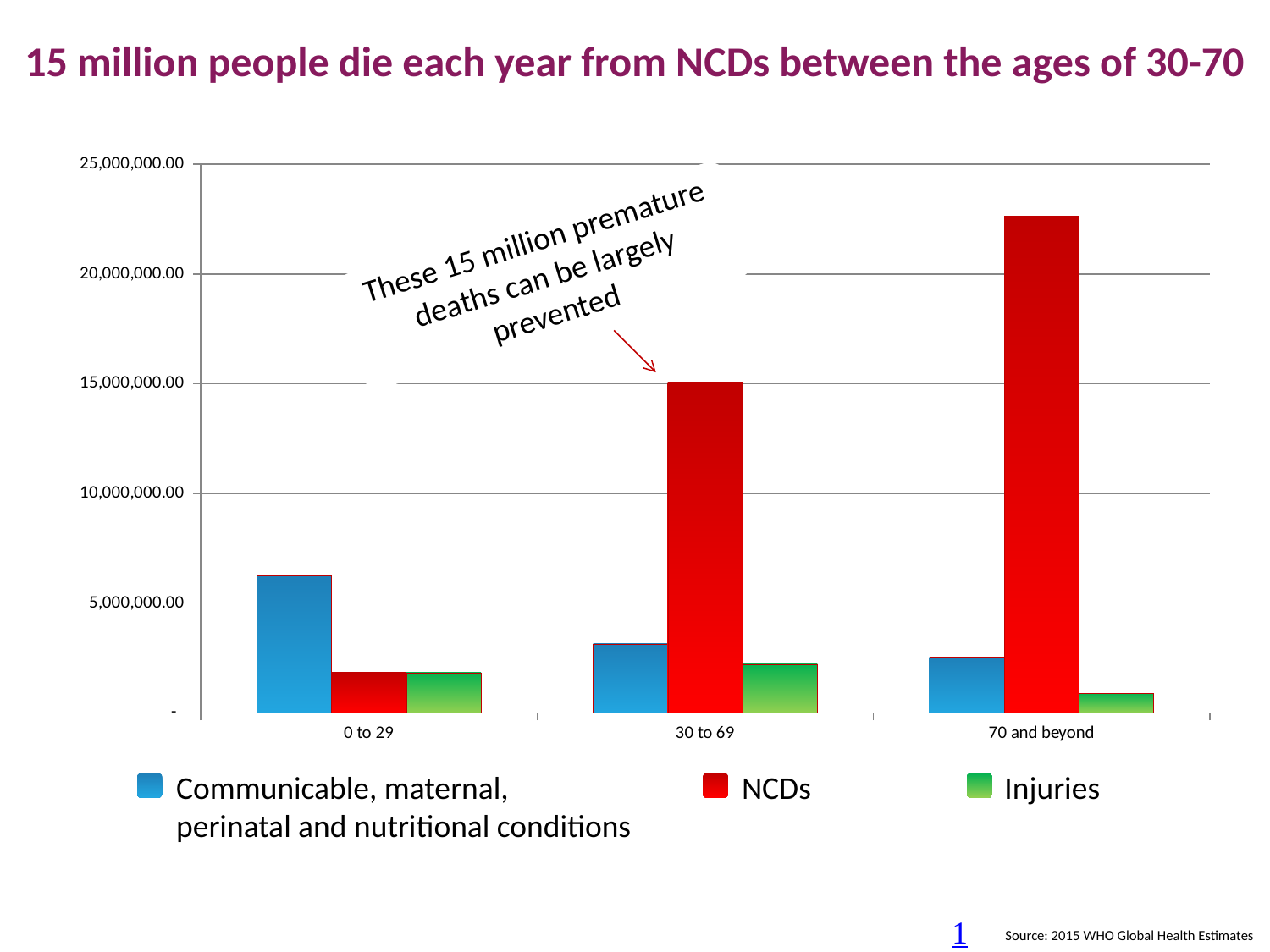
How many series does the legend list? 3 What kind of chart is shown on the slide? Bar chart What is the title of the slide above the chart? 15 million people die each year from NCDs between the ages of 30-70 How many age-group categories are shown on the x axis? 3 Is the value for Communicable, maternal, perinatal and nutritional conditions in the 0 to 29 group greater or less than 5,000,000.00? greater Do the NCDs values rise or fall as the age groups move from 0 to 29 to 70 and beyond? rise Is the Injuries value for 30 to 69 greater or less than 5,000,000.00? less Which age group has the lowest Injuries bar? 70 and beyond Is the NCDs value for 70 and beyond greater or less than 20,000,000.00? greater In the 30 to 69 age group, which series has the highest bar? NCDs Which age group has the highest NCDs bar? 70 and beyond In the 0 to 29 age group, which is larger: Communicable, maternal, perinatal and nutritional conditions or NCDs? Communicable, maternal, perinatal and nutritional conditions